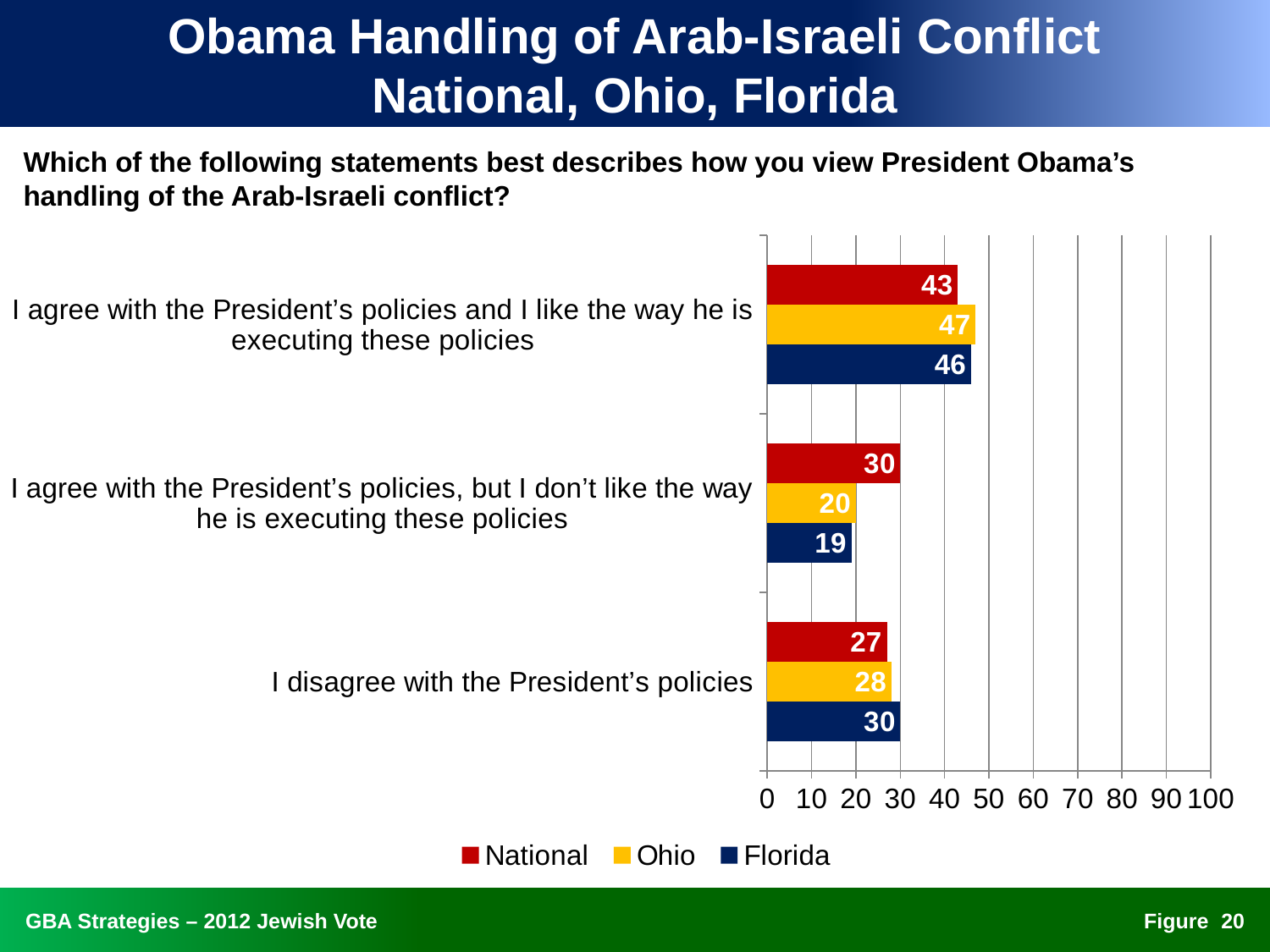
Which category has the lowest Florida value? I agree with the President's policies, but I don't like the way he is executing these policies What is the Ohio value for "I disagree with the President's policies"? 28 Which colour represents Ohio in the legend? Yellow How many series does the legend list? 3 What is the National value for "I agree with the President's policies and I like the way he is executing these policies"? 43 What is the Florida value for "I agree with the President's policies, but I don't like the way he is executing these policies"? 19 Is the Ohio value for "I agree with the President's policies and I like the way he is executing these policies" greater or less than 40? greater Which category has the highest Ohio value? I agree with the President's policies and I like the way he is executing these policies What is the difference between the National and Florida values for "I agree with the President's policies, but I don't like the way he is executing these policies"? 11 How many categories are shown on the chart? 3 For "I disagree with the President's policies", which is larger: the National value or the Florida value? Florida What kind of chart is shown on the slide? Bar chart